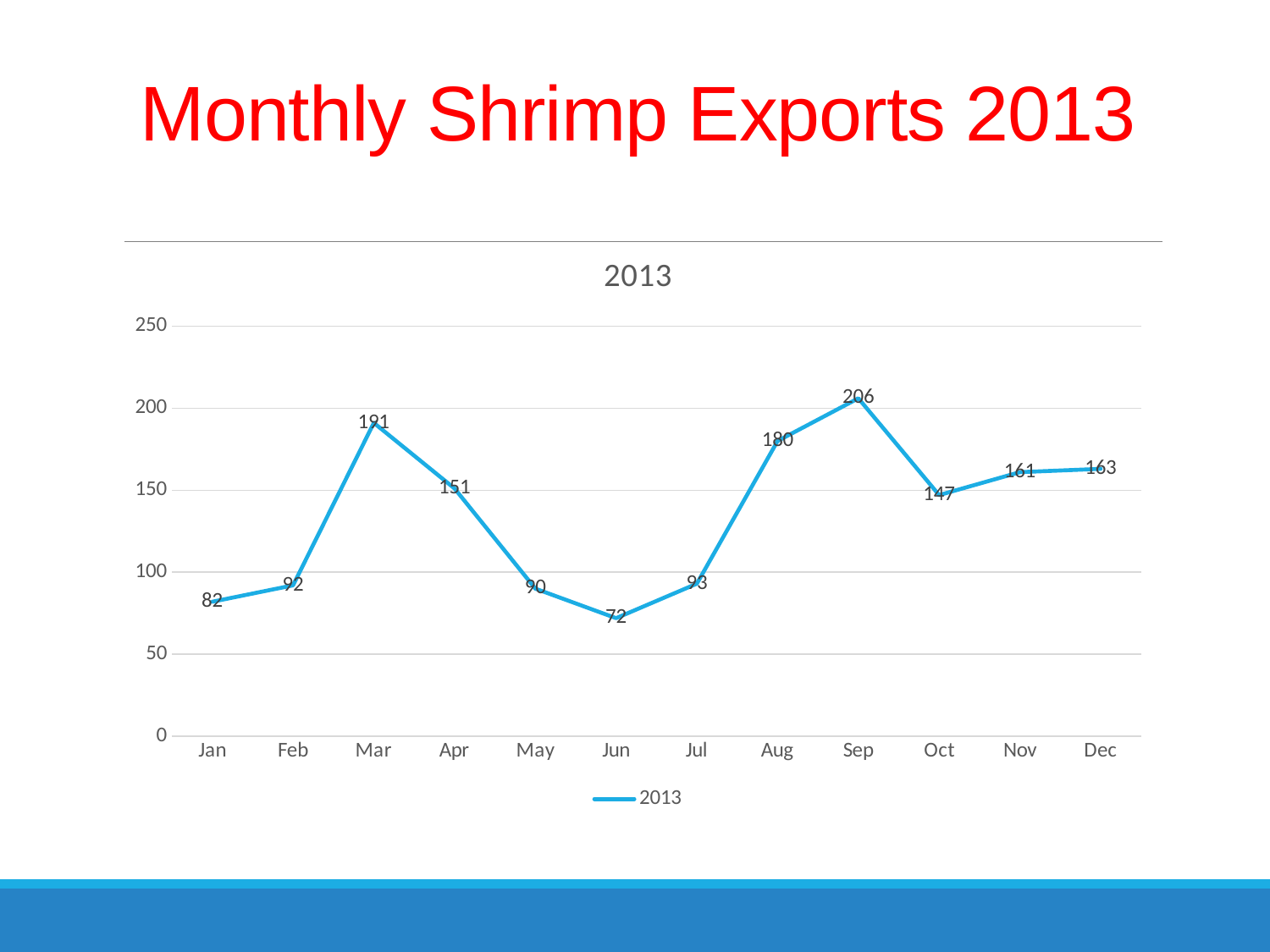
How many series does the legend list? 1 What is the value for Oct? 147 What is the difference between the values for Dec and Nov? 2 Which month has the lowest value? Jun Do the values rise or fall from Mar to Jun? fall How many months are plotted on the x axis? 12 Is the value for Jul greater or less than 100? less Which is larger, the value for Apr or the value for Aug? Aug Which month has the highest value? Sep What is the value for Mar? 191 What kind of chart is shown? line chart What is the difference between the values for Sep and Jun? 134